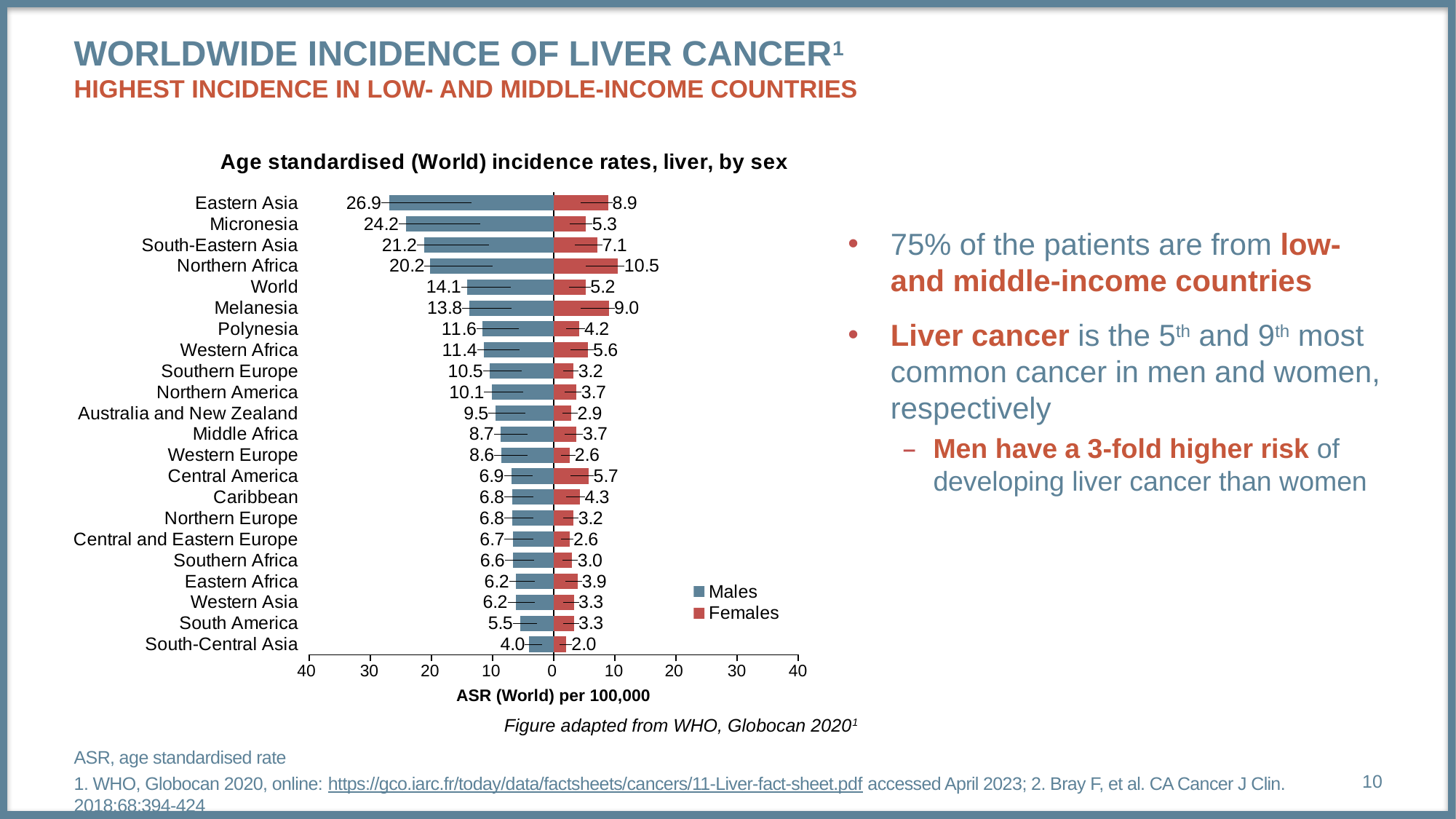
Is the male incidence rate for Micronesia greater or less than 20? greater What is the male incidence rate for the World? 14.1 What is the difference between the male and female incidence rates for Melanesia? 4.8 What kind of chart is shown? Bar chart How many regions are listed on the chart? 22 Which region has the lowest female incidence rate? South-Central Asia Which is larger, the female rate for Central America or the female rate for Micronesia? Central America What is the male incidence rate for Eastern Asia? 26.9 Which region has the highest male incidence rate? Eastern Asia Which region has the highest female incidence rate? Northern Africa How many series does the legend list? 2 What is the female incidence rate for Northern Africa? 10.5